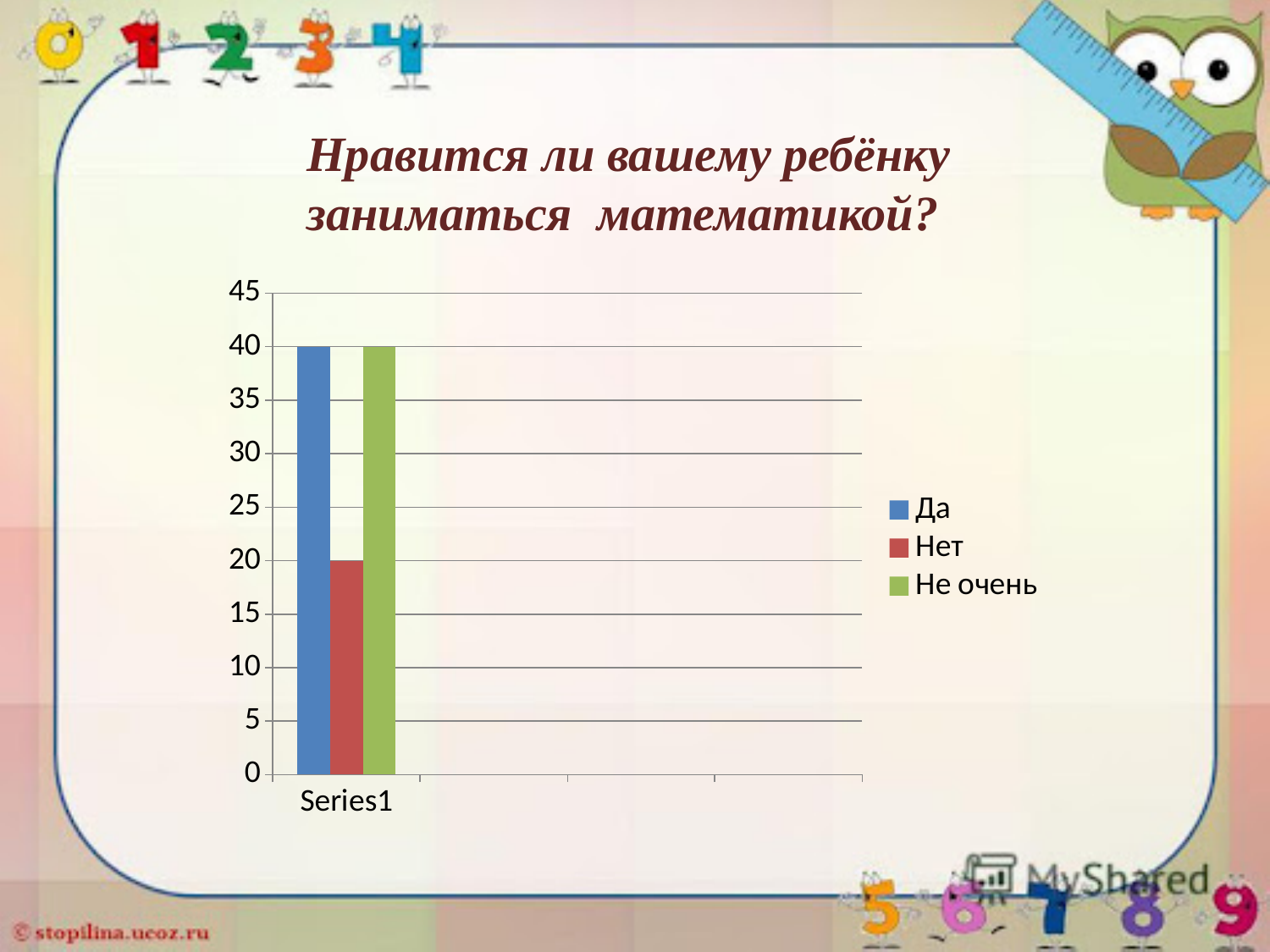
What kind of chart is shown on the slide? bar chart What is the difference between the Да value and the Нет value? 20 What is the title of the chart? Нравится ли вашему ребёнку заниматься математикой? Is the value for Нет greater or less than 25? less Which is larger, the value for Да or the value for Нет? Да Which series has the lowest value? Нет What is the value of the Да bar? 40 What is the value of the Не очень bar? 40 What is the value of the Нет bar? 20 What colour is the Не очень series in the legend? green How many series does the legend list? 3 Is the value for Не очень greater or less than 35? greater